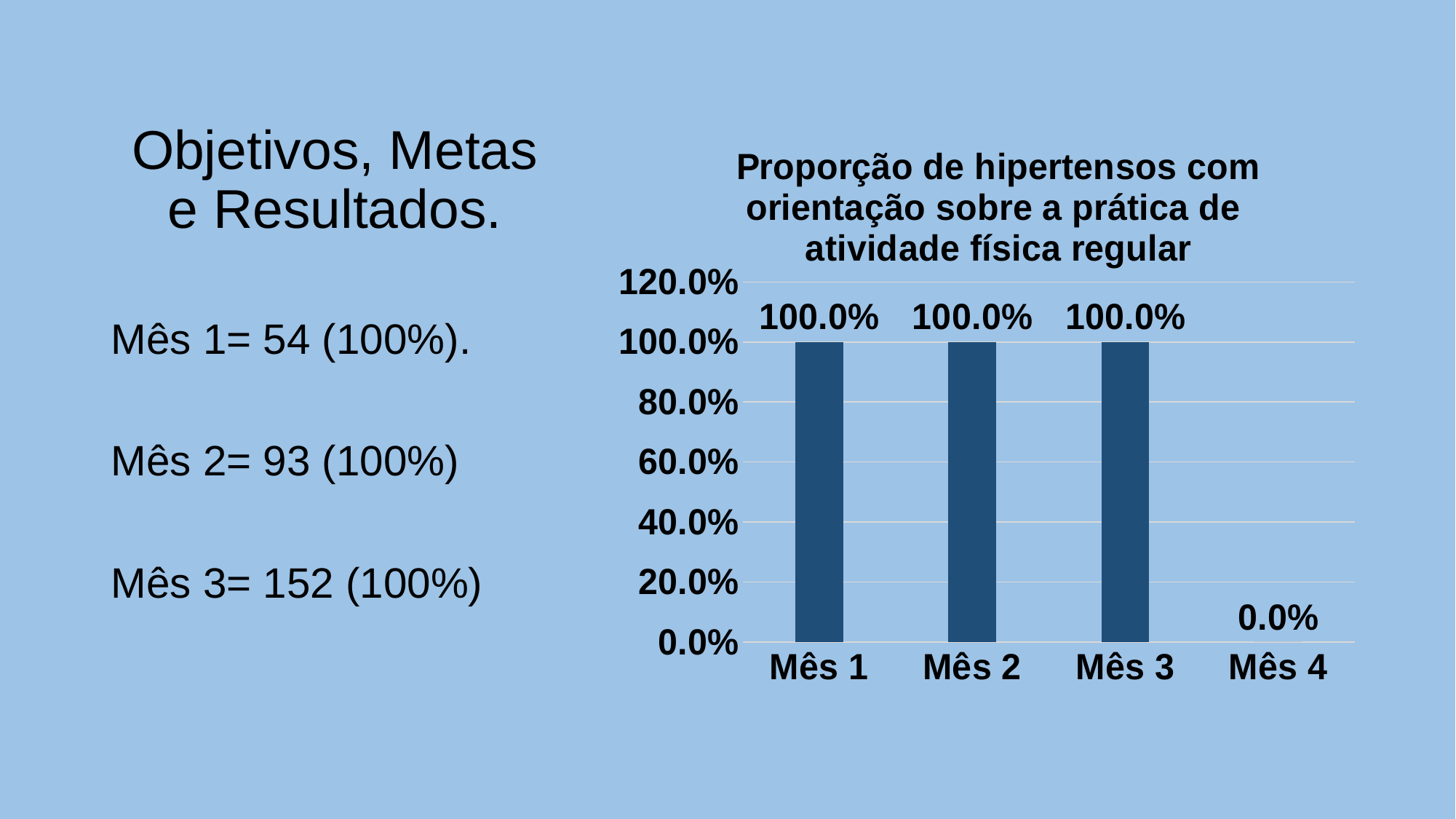
What is the difference between the values for Mês 2 and Mês 4? 100.0% What is the value for Mês 3? 100.0% How many categories are shown on the x axis? 4 Is the value for Mês 2 greater or less than 80.0%? greater What kind of chart is shown on the slide? bar chart Which is larger, the value for Mês 3 or the value for Mês 4? Mês 3 What is the value for Mês 4? 0.0% What is the value for Mês 1? 100.0% What is the title of the chart? Proporção de hipertensos com orientação sobre a prática de atividade física regular Do the values for Mês 1, Mês 2 and Mês 3 differ from each other? No, all are 100.0% What is the highest value shown on the y axis? 120.0% Which category has the lowest value? Mês 4